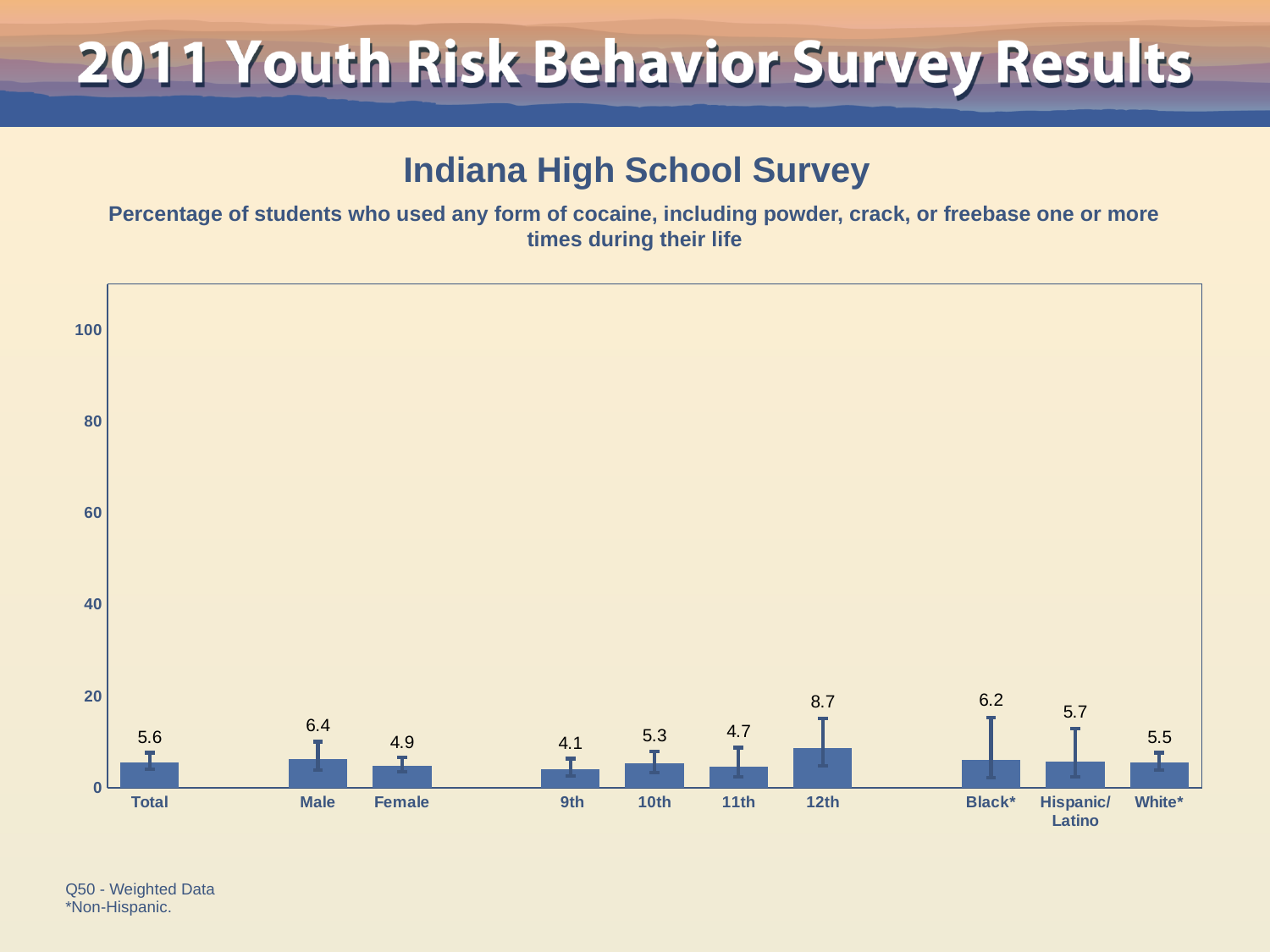
What is the value for Total? 5.6 Which category has the lowest value? 9th What is the value for 12th grade? 8.7 Which category has the highest value? 12th What is the value for Hispanic/Latino students? 5.7 Which is larger, the value for Black* or the value for White*? Black* What is the difference between the Male and Female values? 1.5 What kind of chart is this? bar chart Is the value for 12th grade greater or less than 20? less How many categories are shown on the x axis? 10 What is the difference between the 12th grade and 9th grade values? 4.6